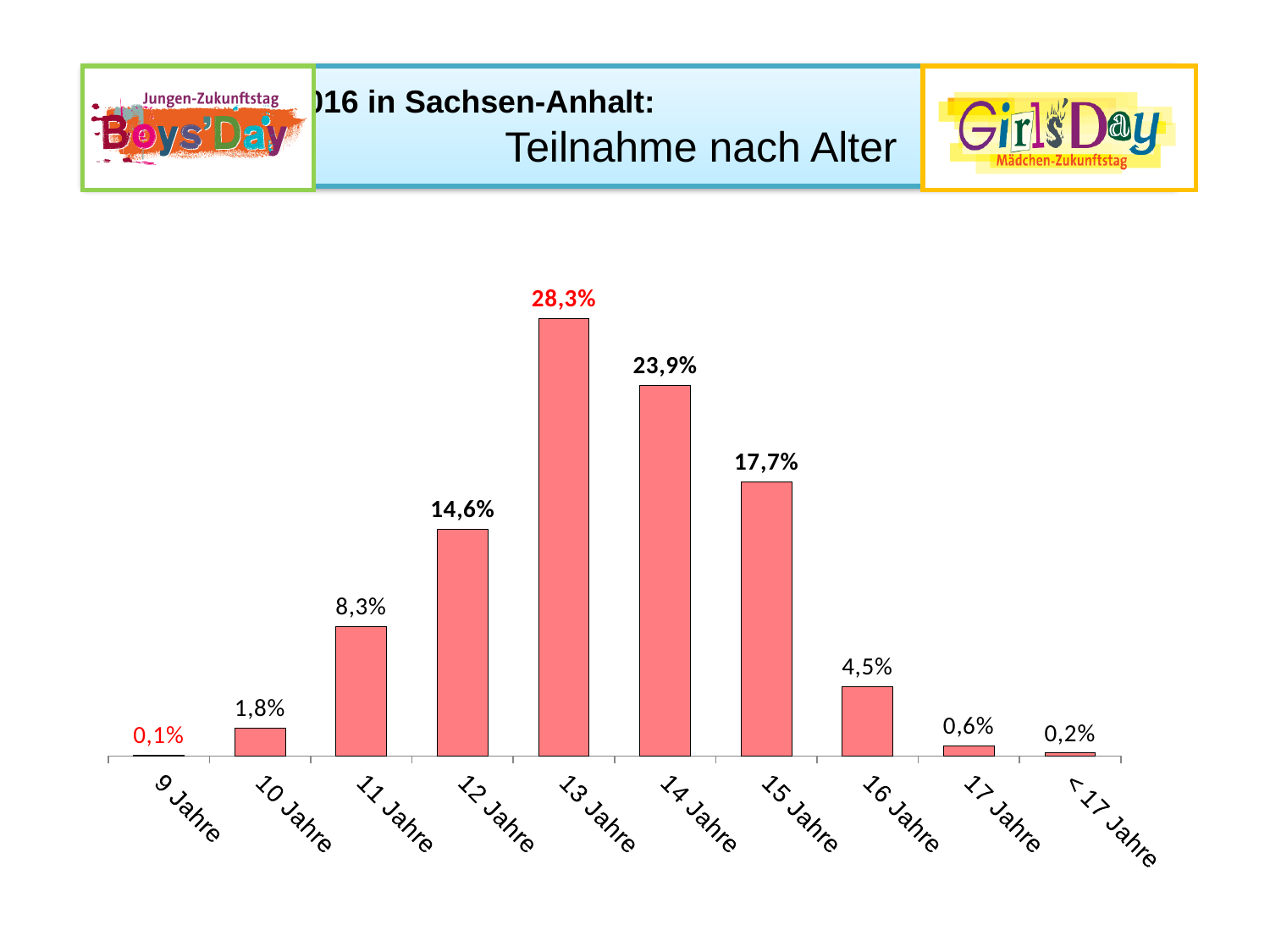
What is the value for 11 Jahre? 8,3% What is the difference between the values for 13 Jahre and 14 Jahre? 4,4% What is the value for 13 Jahre? 28,3% How many age categories are shown on the x axis? 10 Which age category has the lowest value? 9 Jahre Which two data labels are printed in red? 0,1% (9 Jahre) and 28,3% (13 Jahre) What kind of chart is shown on the slide? Bar chart What is the value for 16 Jahre? 4,5% Which is larger, the value for 15 Jahre or the value for 12 Jahre? 15 Jahre Do the values rise or fall from 13 Jahre to 17 Jahre? Fall Which age category has the highest value? 13 Jahre What is the difference between the values for 12 Jahre and 11 Jahre? 6,3%